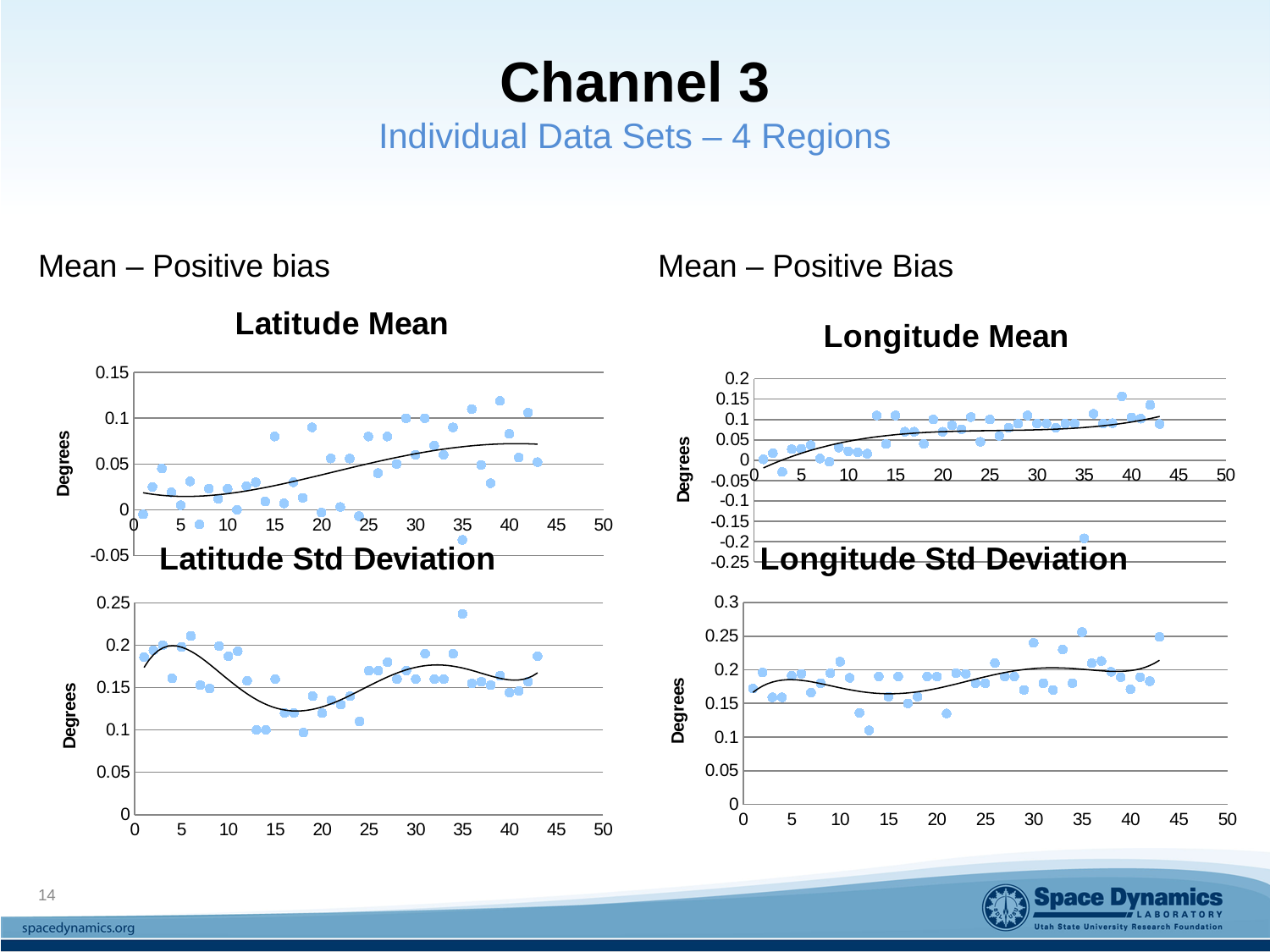
In the Longitude Mean chart, does the fitted trend line rise or fall as the x value increases? rise What is the y-axis label on the Longitude Std Deviation chart? Degrees What is the maximum value shown on the y-axis of the Longitude Std Deviation chart? 0.3 How many charts are shown on the slide? 4 In the Longitude Mean chart, is the lowest plotted point greater or less than -0.15? less What is the maximum value shown on the x-axis of the Latitude Std Deviation chart? 50 In the Longitude Std Deviation chart, is the lowest plotted point greater or less than 0.15? less In the Latitude Mean chart, is the highest plotted point greater or less than 0.1? greater What kind of chart is the Latitude Mean chart? scatter chart In the Latitude Mean chart, does the fitted trend line rise or fall as the x value increases? rise What is the title of the chart in the top-right position of the slide? Longitude Mean